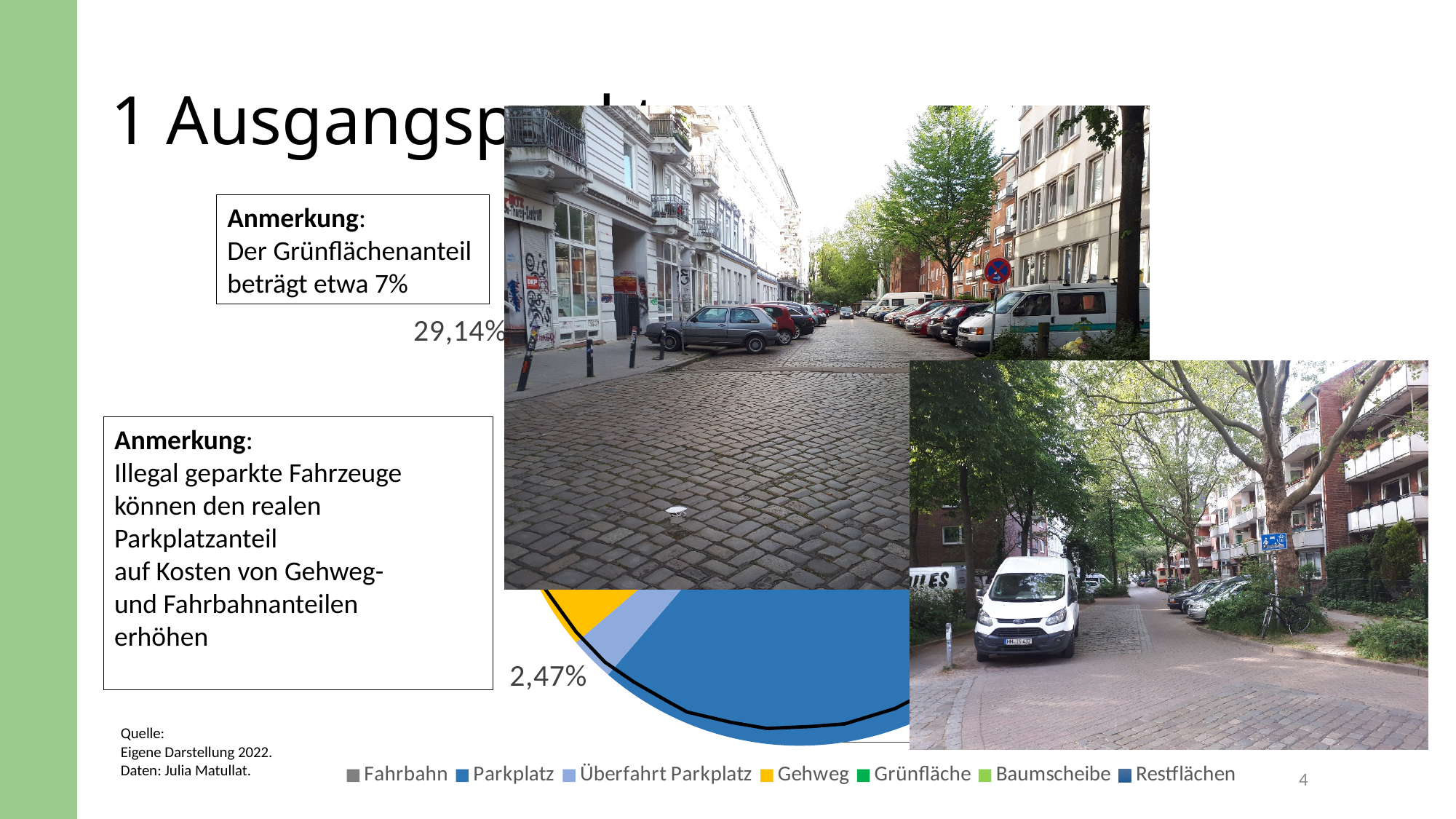
Which of the two printed percentage labels on the chart is larger, 29,14% or 2,47%? 29,14% What is the difference between the two printed percentage labels 29,14% and 2,47%? 26,67% What percentage label is printed above the pie chart, to the left of the upper photo? 29,14% Which legend entry is shown in yellow? Gehweg How many categories does the chart legend list? 7 What kind of chart is shown on the slide? pie chart Which legend entry is listed first in the chart legend? Fahrbahn What percentage label is printed at the lower left of the pie chart? 2,47%